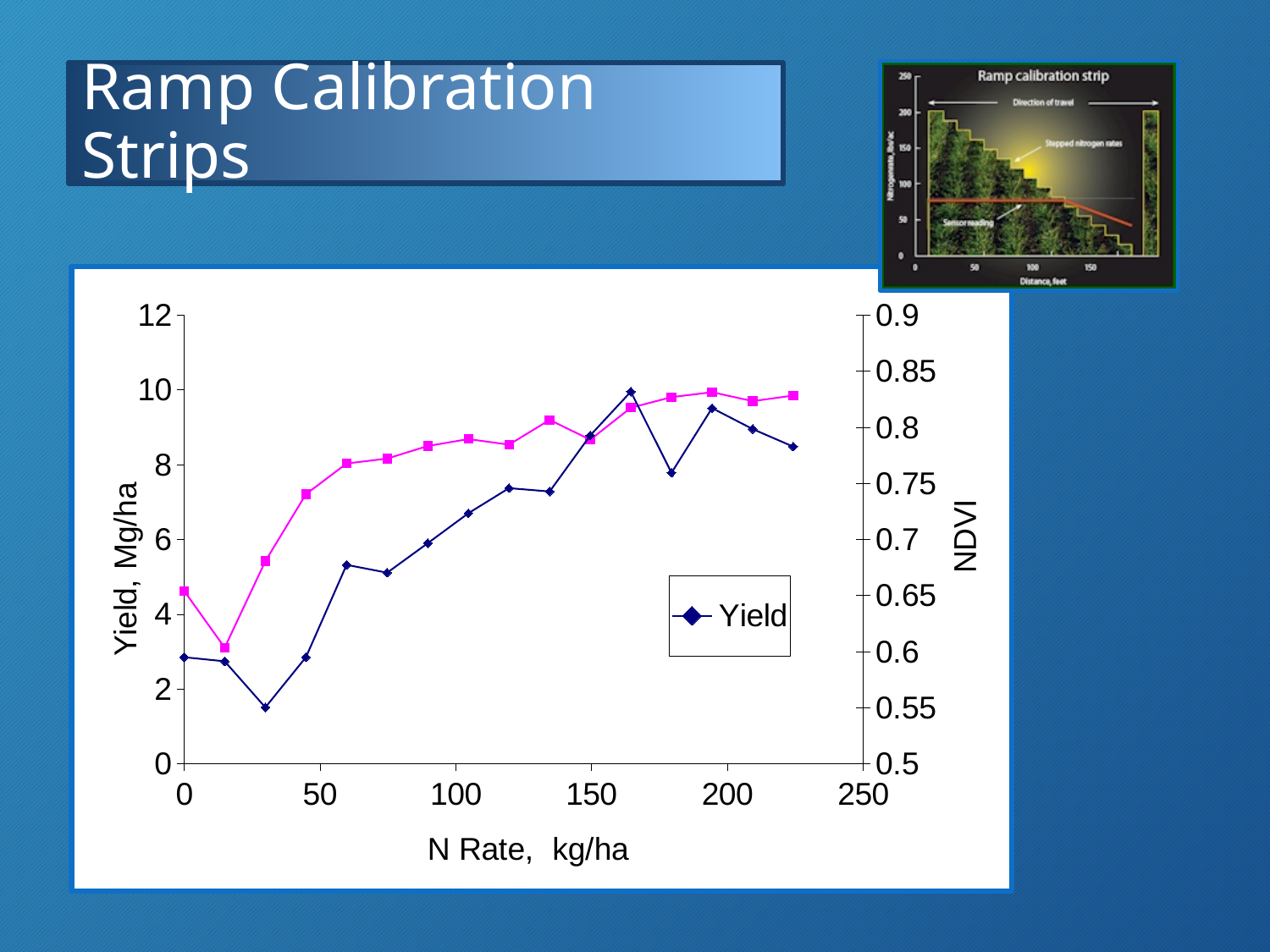
Is the Yield value at an N rate of 0 greater or less than 2? greater Which is larger, the Yield value at an N rate of 165 or at an N rate of 180? 165 Is the Yield value at an N rate of 60 greater or less than 4? greater What kind of chart is shown on the slide? line chart What is the title of the x axis of the chart? N Rate, kg/ha Is the Yield value at an N rate of 150 greater or less than 8? greater How many series does the chart's legend list? 1 Overall, does the Yield series rise or fall as the N rate increases from 0 to 250? rise What is the title of the left y axis of the chart? Yield, Mg/ha